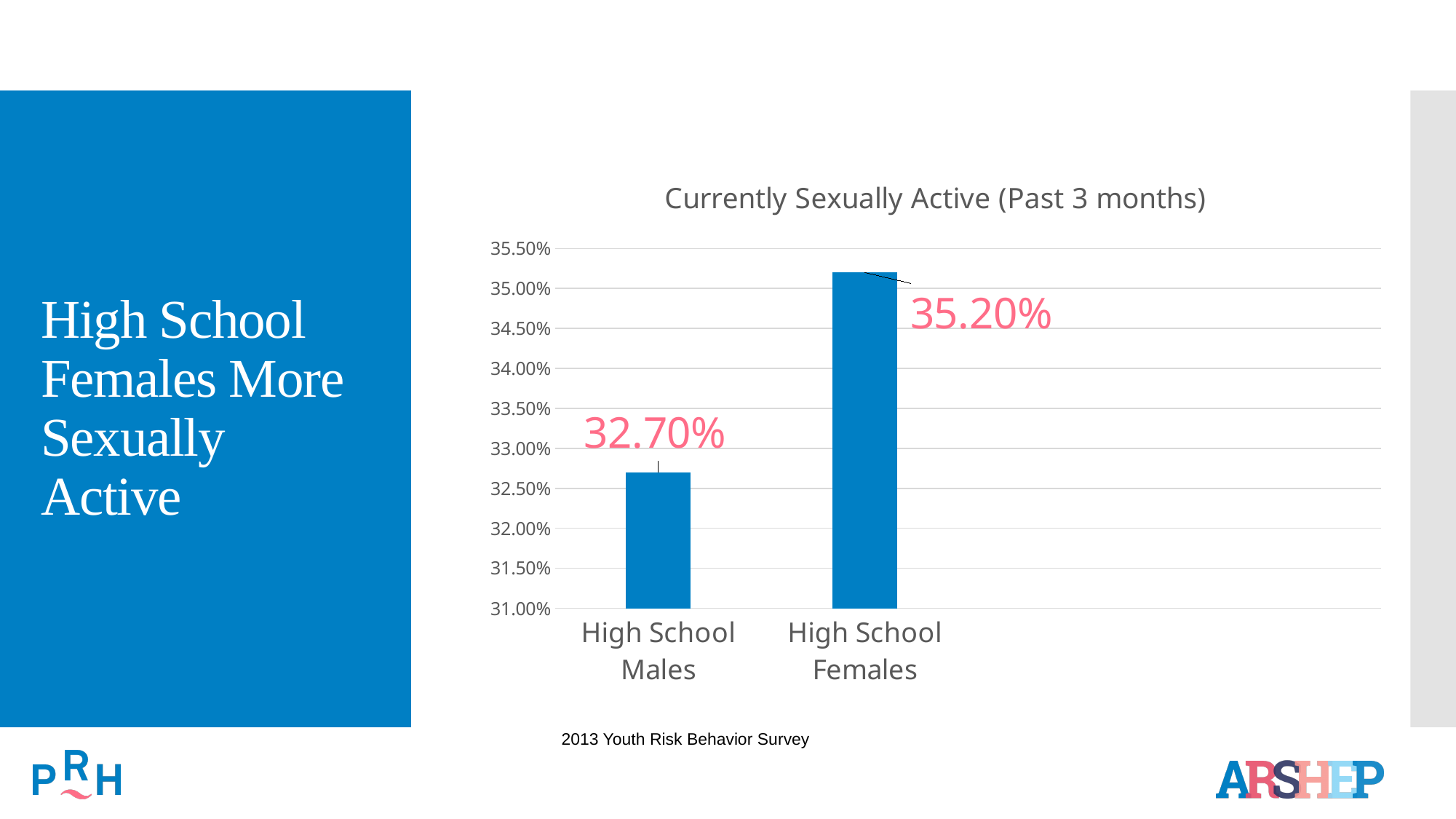
Is the value for High School Females greater or less than 35.00%? greater What is the value for High School Females? 35.20% Which category has the lowest value? High School Males What is the value for High School Males? 32.70% What kind of chart is shown on the slide? bar chart Which category has the highest value? High School Females Which is larger, the value for High School Males or High School Females? High School Females How many categories are shown on the chart? 2 Is the value for High School Males greater or less than 33.00%? less What is the difference between the values for High School Females and High School Males? 2.50% What is the lowest value shown on the y axis? 31.00% What is the title of the chart? Currently Sexually Active (Past 3 months)